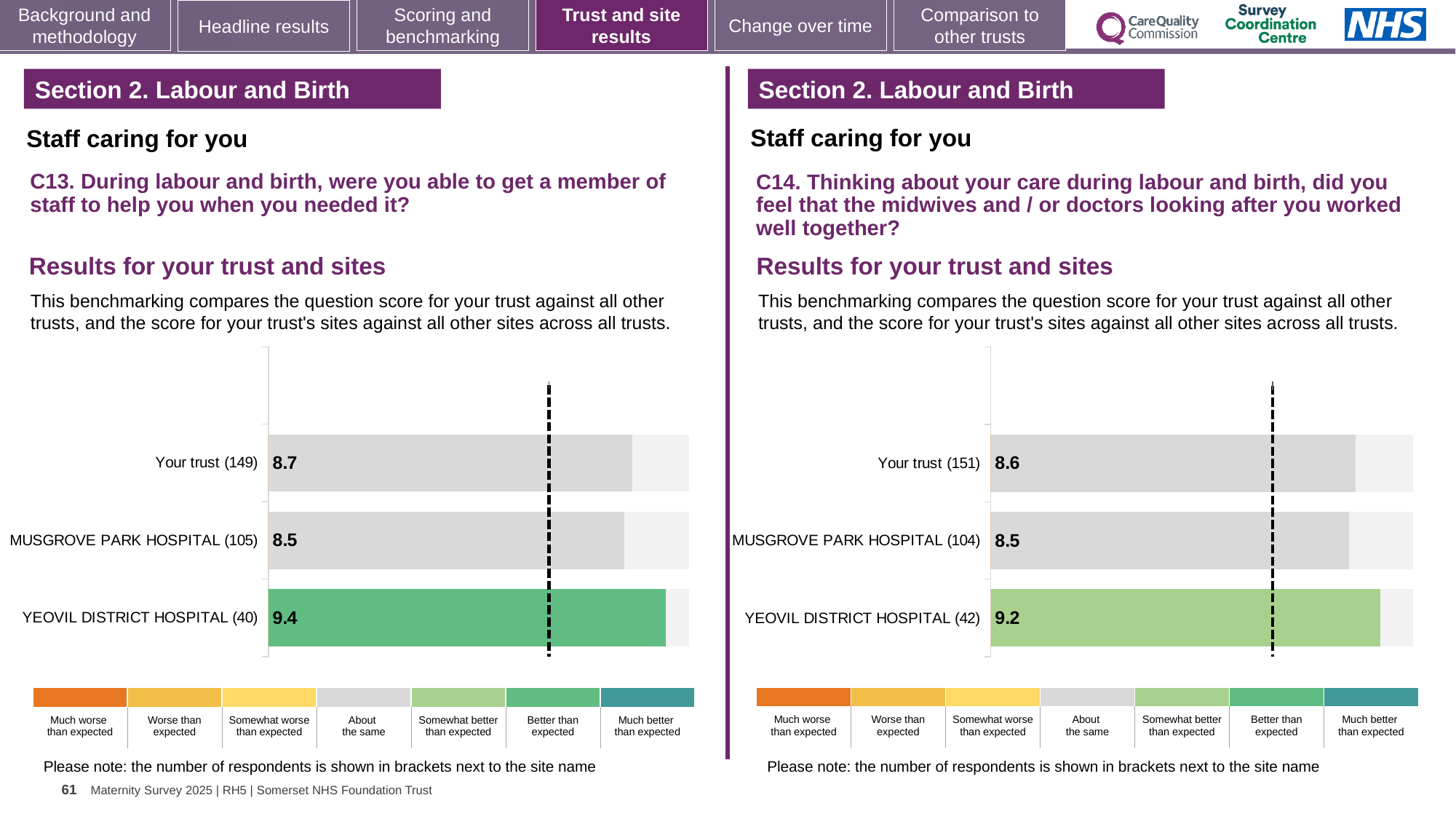
Which is larger: the score for YEOVIL DISTRICT HOSPITAL in the C13 chart on the left or in the C14 chart on the right? C13 chart on the left In the C13 chart on the left, which site or trust has the lowest score? MUSGROVE PARK HOSPITAL (105) In the C14 chart on the right, which site or trust has the highest score? YEOVIL DISTRICT HOSPITAL (42) How many bars are shown in the C13 chart on the left? 3 In the C13 chart on the left, what is the score for YEOVIL DISTRICT HOSPITAL (40)? 9.4 In the C13 chart on the left, which site or trust has the highest score? YEOVIL DISTRICT HOSPITAL (40) In the C13 chart on the left, what is the difference between the scores for YEOVIL DISTRICT HOSPITAL (40) and MUSGROVE PARK HOSPITAL (105)? 0.9 In the C13 chart on the left, what is the score for Your trust (149)? 8.7 In the C14 chart on the right, what is the score for MUSGROVE PARK HOSPITAL (104)? 8.5 In the C14 chart on the right, what is the score for Your trust (151)? 8.6 What kind of chart is the C14 chart on the right? Bar chart In the C14 chart on the right, what is the difference between the scores for YEOVIL DISTRICT HOSPITAL (42) and Your trust (151)? 0.6